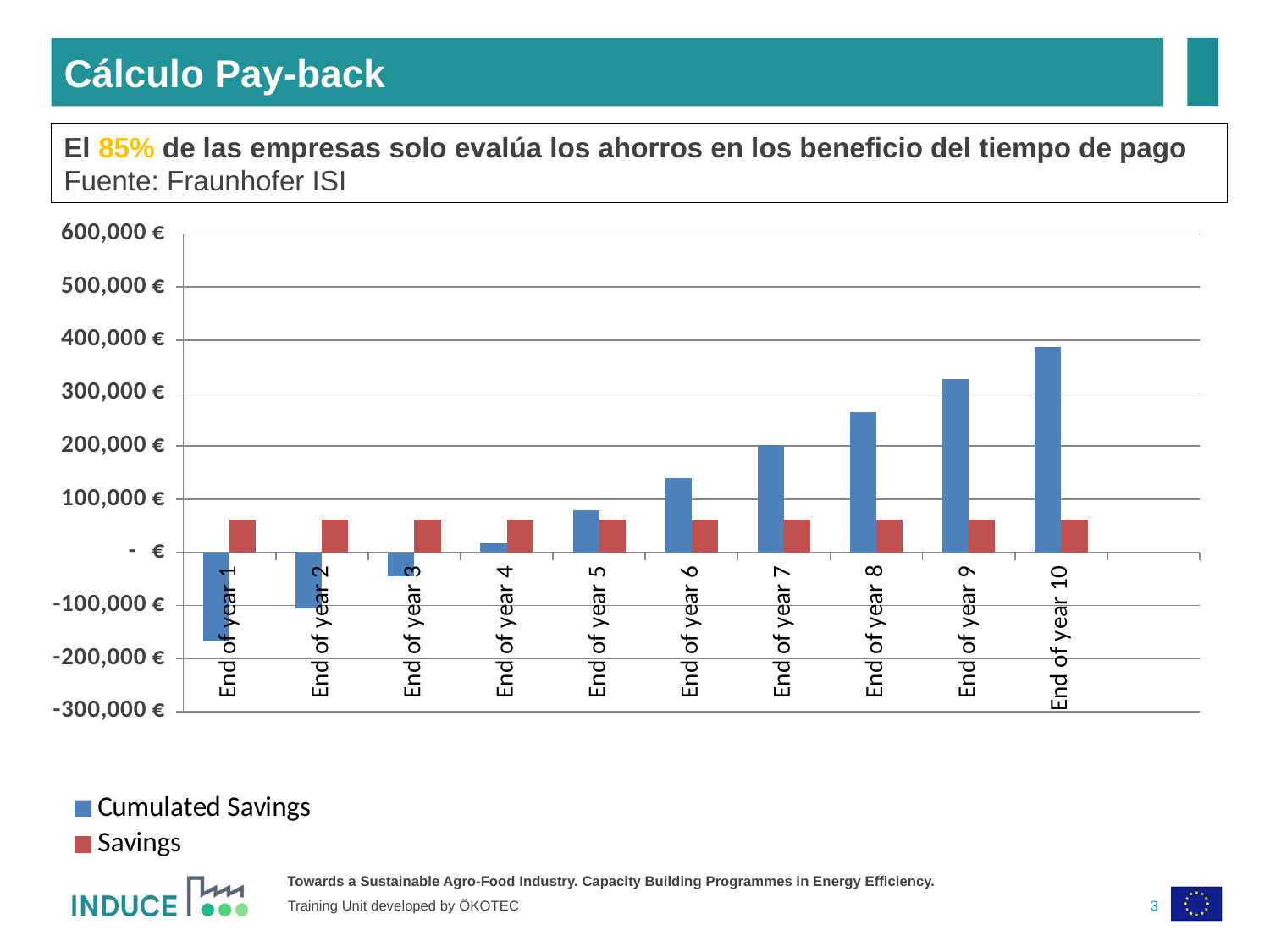
How many categories are shown along the x axis? 10 Which category has the highest Cumulated Savings value? End of year 10 What is the highest value shown on the vertical axis? 600,000 € Do the Cumulated Savings values rise or fall from End of year 1 to End of year 10? rise Which series is shown in blue in the legend? Cumulated Savings Which is larger for End of year 8: Cumulated Savings or Savings? Cumulated Savings How many series does the legend list? 2 Which category has the lowest Cumulated Savings value? End of year 1 Is the Cumulated Savings value for End of year 1 greater or less than -100,000 €? less Is the Savings value for End of year 5 greater or less than 100,000 €? less What kind of chart is shown on the slide? bar chart Is the Cumulated Savings value for End of year 10 greater or less than 300,000 €? greater